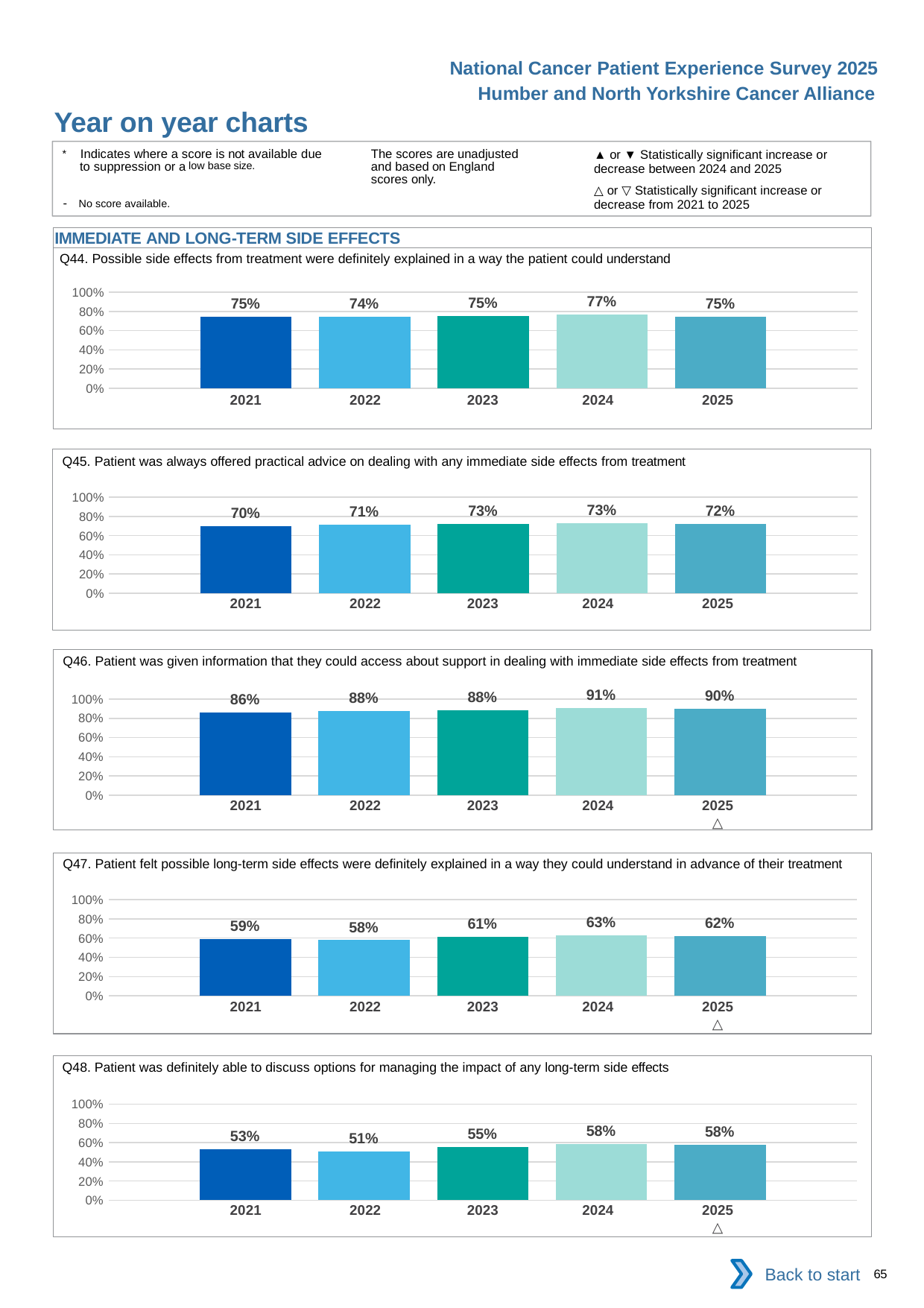
In the Q48 chart, what is the value for 2022? 51% In the Q47 chart, what is the difference between the 2024 and 2022 values? 5 percentage points In the Q47 chart, is the value for 2021 greater or less than 80%? less In the Q46 chart, what is the difference between the 2025 and 2021 values? 4 percentage points In the Q45 chart, which year has the lowest value? 2021 In the Q46 chart, which year has the highest value? 2024 How many years are plotted in the Q44 chart? 5 In the Q45 chart, what is the value for 2025? 72% What type of chart is the Q46 chart? bar chart Which section heading appears above the Q44 chart? IMMEDIATE AND LONG-TERM SIDE EFFECTS In the Q44 chart, what is the value for 2024? 77% In the Q48 chart, is the value for 2023 larger or smaller than the value for 2021? larger